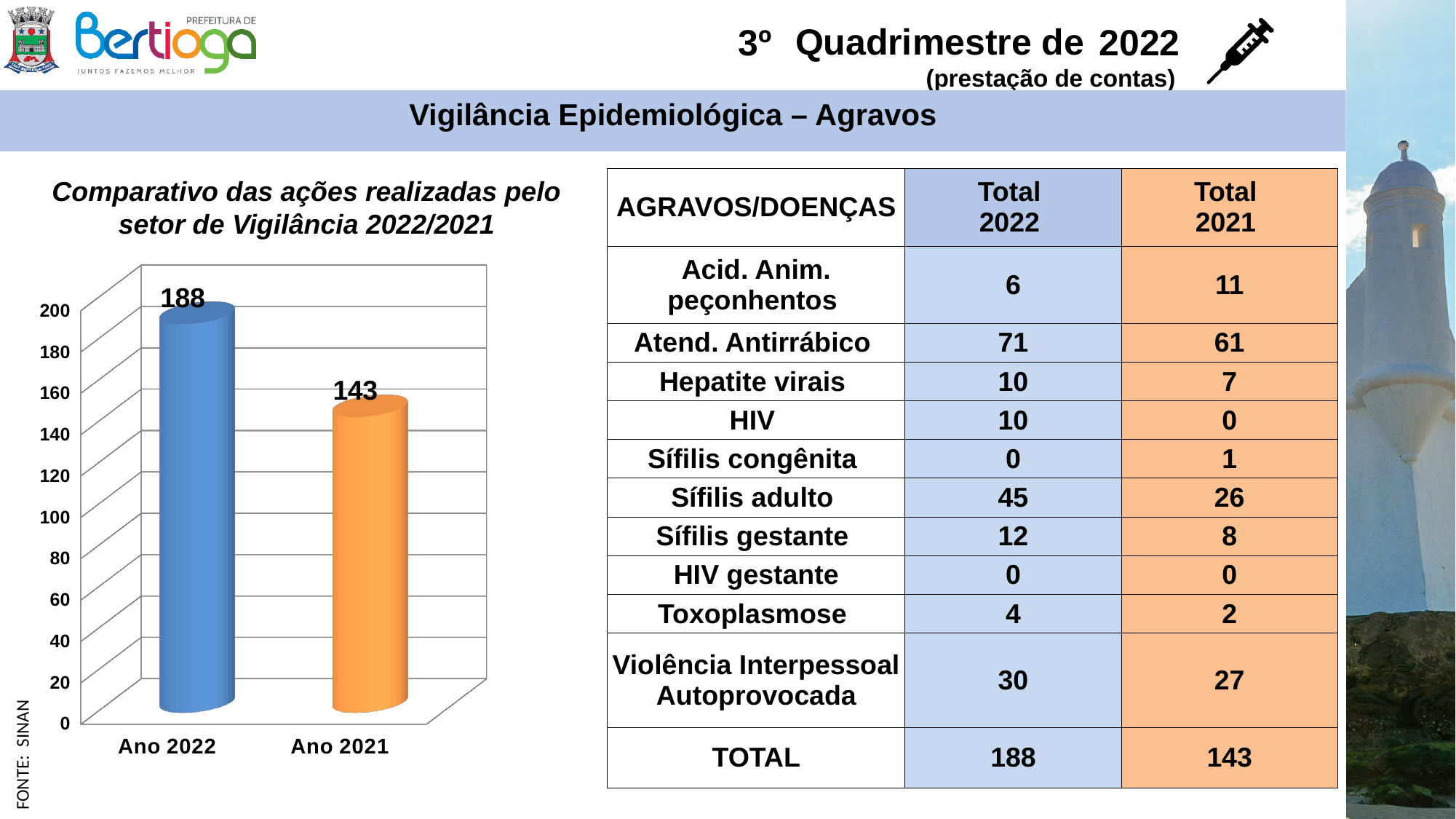
How many categories are shown in the chart? 2 Which category has the lowest value in the chart? Ano 2021 Is the value for Ano 2021 greater or less than 160? less What is the difference between the values for Ano 2022 and Ano 2021 in the chart? 45 Which is larger in the chart, the value for Ano 2022 or Ano 2021? Ano 2022 What is the title of the chart? Comparativo das ações realizadas pelo setor de Vigilância 2022/2021 What is the value for Ano 2021 in the chart? 143 Which category has the highest value in the chart? Ano 2022 Is the value for Ano 2022 greater or less than 180? greater What colour is the bar for Ano 2021 in the chart? orange What kind of chart is shown on the slide? bar chart What is the value for Ano 2022 in the chart? 188